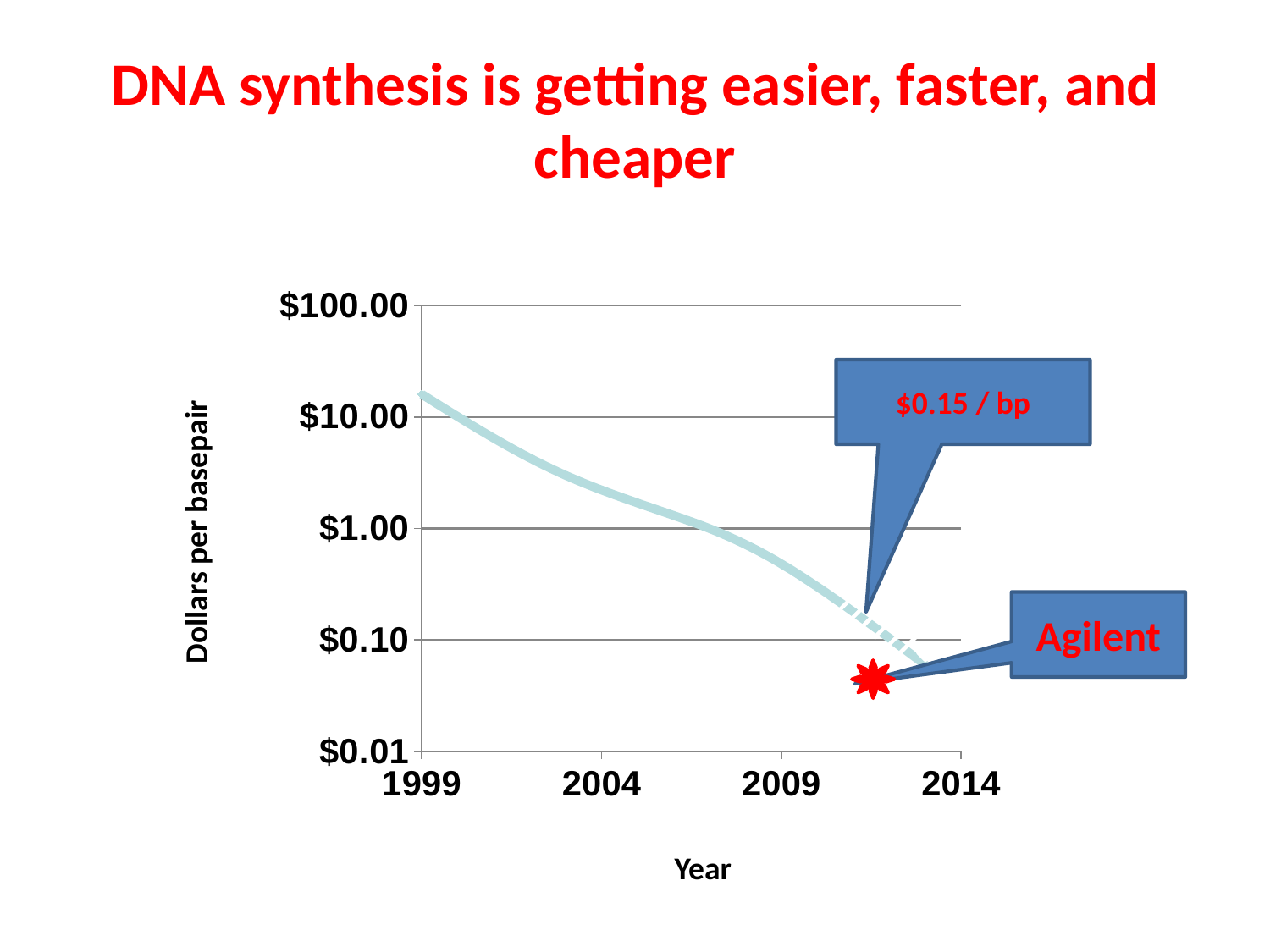
Does the cost per basepair rise or fall from 1999 to 2014? fall Is the value for 2009 greater or less than $1.00? less How many year labels are shown on the x axis? 4 Which company is named in the callout pointing to the red star? Agilent Is the value for 2009 greater or less than $0.10? greater What kind of chart is shown on the slide? line chart Is the value for 2004 greater or less than $10.00? less What is the label of the y axis? Dollars per basepair What cost per basepair does the callout on the chart state? $0.15 / bp Which year has the higher cost per basepair, 1999 or 2009? 1999